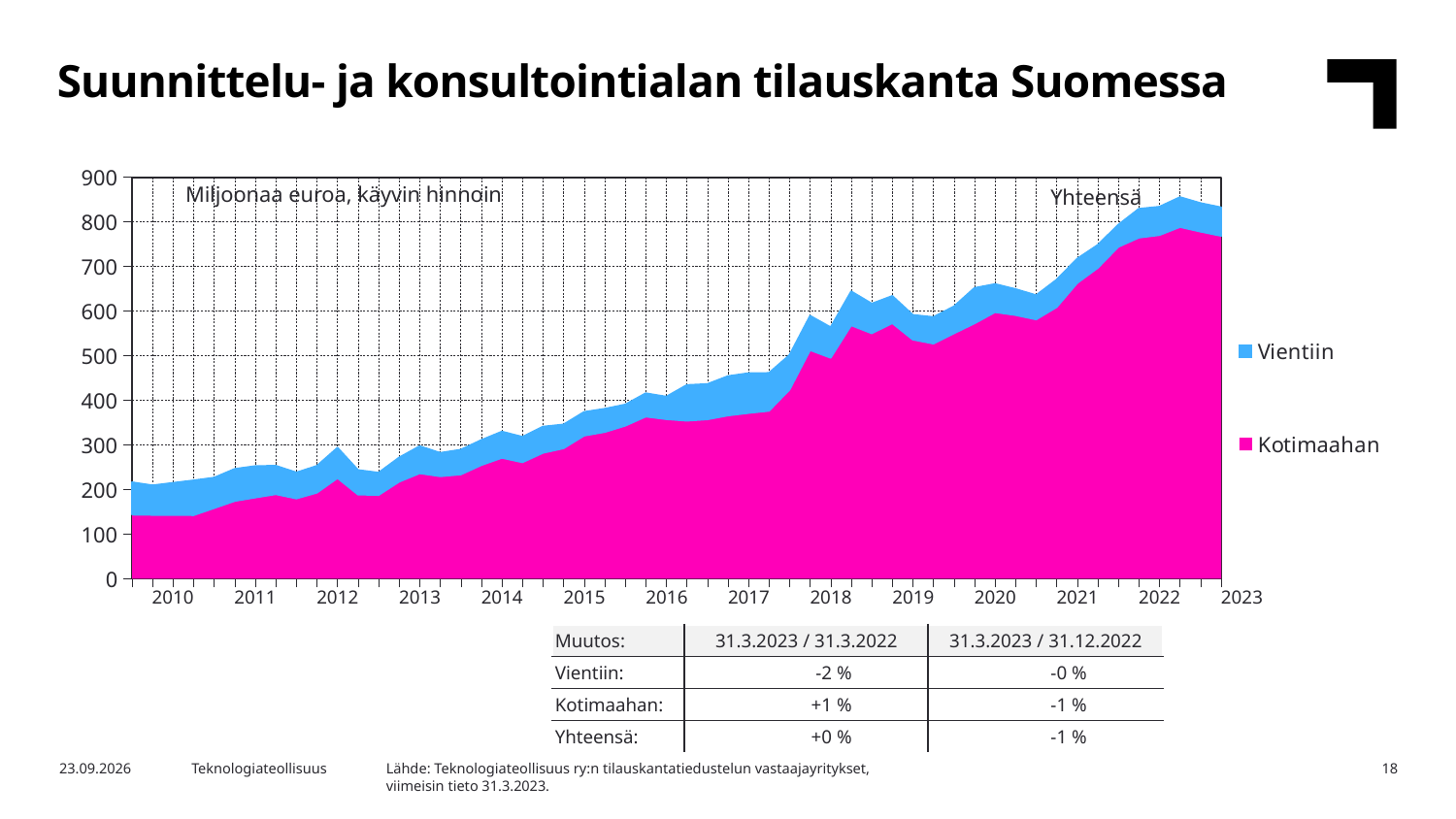
How many year labels are shown on the x axis? 14 Is the total value at the start of 2010 greater or less than 300? less In which year does the total order backlog reach its highest level? 2022 Which series is larger throughout the chart, Vientiin or Kotimaahan? Kotimaahan Is the Kotimaahan value at the end of the series in 2023 greater or less than 700? greater Does the total order backlog (Yhteensä) generally rise or fall from 2010 to 2023? Rise What unit is stated in the label inside the chart area? Miljoonaa euroa, käyvin hinnoin Is the total value at its peak in 2022 greater or less than 800? greater What kind of chart is shown on the slide? Stacked area chart Which two series are listed in the chart legend? Vientiin and Kotimaahan How many series does the chart legend list? 2